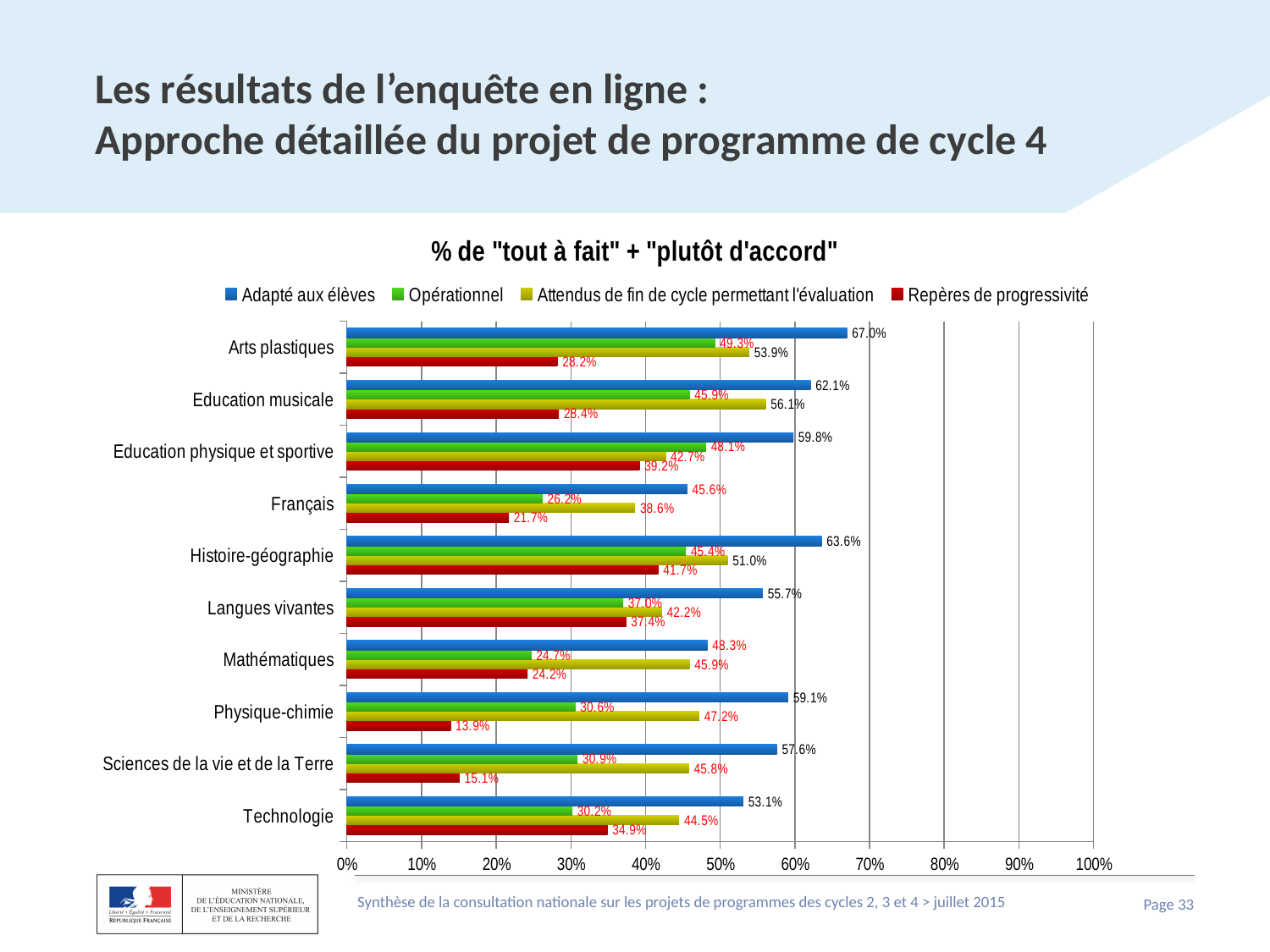
Which category has the lowest value for "Adapté aux élèves"? Français How many categories (subjects) are shown on the chart? 10 What is the value for "Opérationnel" for Français? 26.2% Which category has the lowest value for "Repères de progressivité"? Physique-chimie Which category has the highest value for "Adapté aux élèves"? Arts plastiques Which is larger for Technologie: the "Opérationnel" value or the "Repères de progressivité" value? Repères de progressivité What is the value for "Attendus de fin de cycle permettant l'évaluation" for Education musicale? 56.1% What is the difference between the "Adapté aux élèves" value and the "Repères de progressivité" value for Arts plastiques? 38.8 percentage points How many series does the legend list? 4 What kind of chart is shown on the slide? Bar chart What is the value for "Repères de progressivité" for Physique-chimie? 13.9% What is the value for "Adapté aux élèves" for Arts plastiques? 67.0%